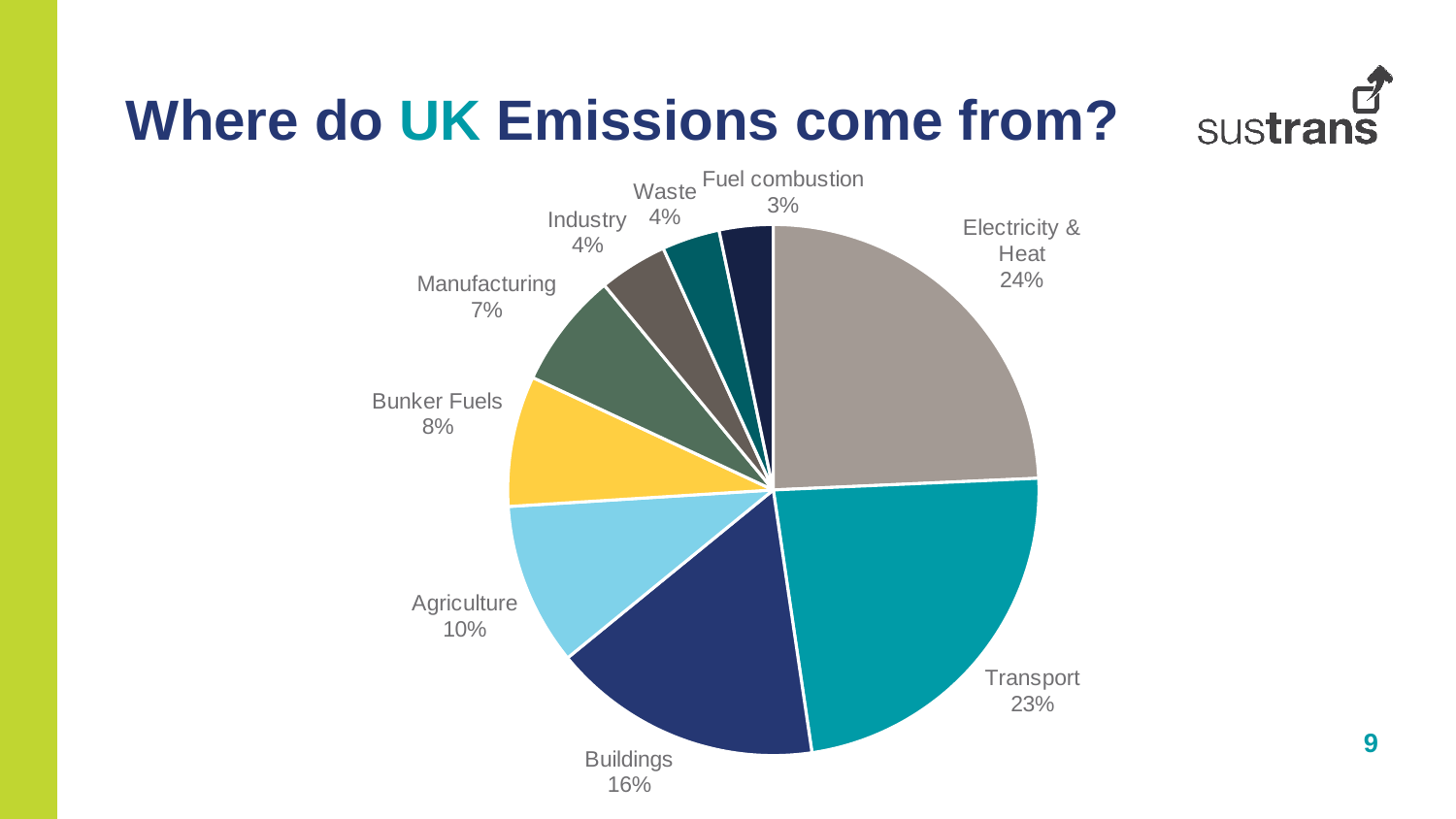
What share of UK emissions comes from Bunker Fuels? 8% What is the combined share of Transport and Buildings? 39% How many categories are shown in the pie chart? 9 Which is larger, the share for Manufacturing or the share for Agriculture? Agriculture Which category accounts for the smallest share of UK emissions? Fuel combustion What share of UK emissions comes from Buildings? 16% What colour is the Bunker Fuels slice? yellow What is the title of the slide containing the chart? Where do UK Emissions come from? What is the difference in percentage points between Electricity & Heat and Agriculture? 14 What kind of chart is shown on the slide? pie chart Which category accounts for the largest share of UK emissions? Electricity & Heat What share of UK emissions comes from Transport? 23%